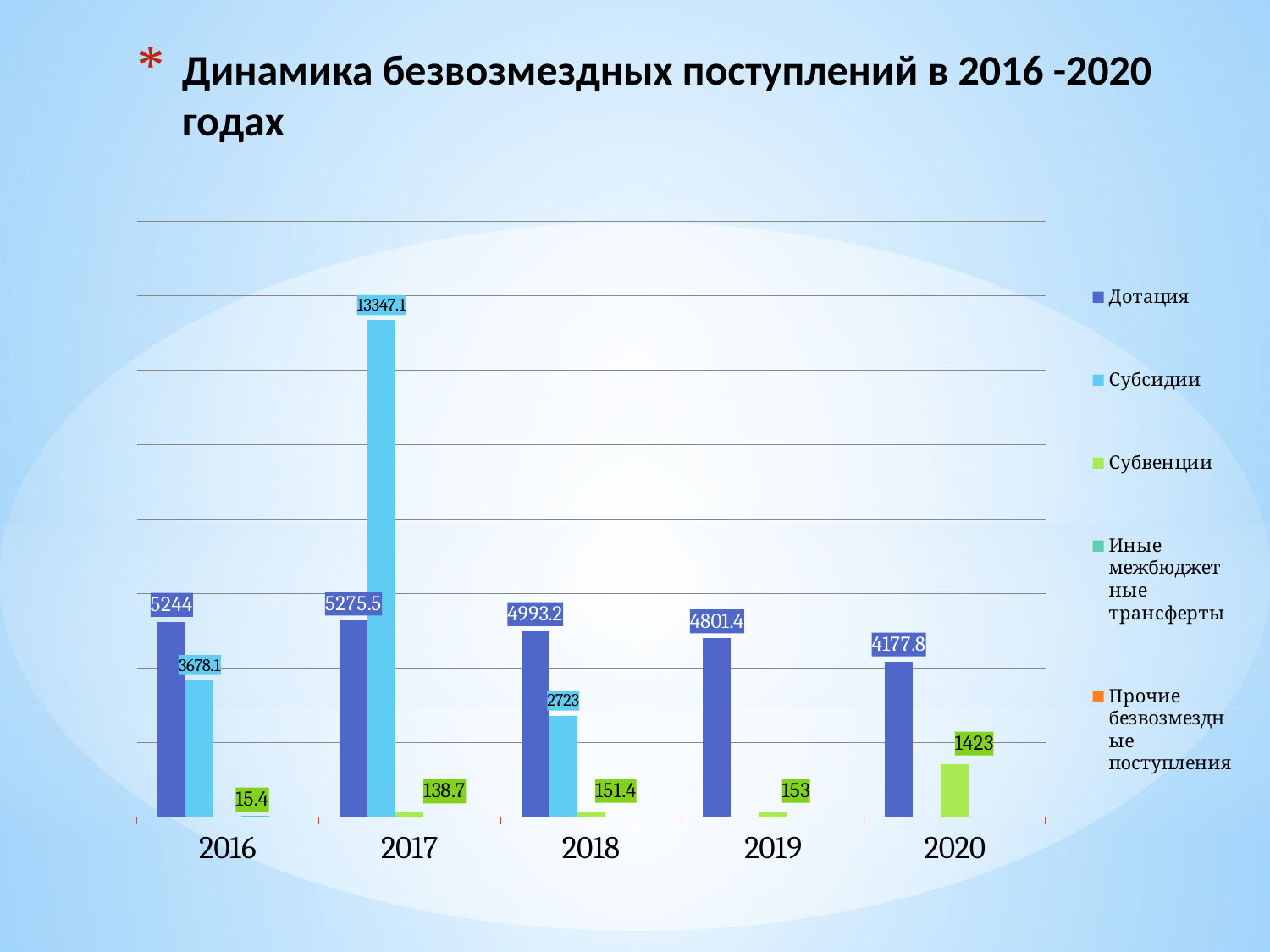
In which year is Дотация the lowest? 2020 What type of chart is shown on the slide? bar chart Which is larger in 2018: Дотация or Субсидии? Дотация What is the value of Субсидии in 2018? 2723 What is the difference between Дотация in 2016 and Дотация in 2020? 1066.2 How many series does the legend list? 5 How many years are shown on the x axis? 5 What is the value of Субсидии in 2017? 13347.1 In which year is Субсидии the highest? 2017 What is the value of Дотация in 2016? 5244 Does Дотация rise or fall from 2017 to 2020? fall What is the value of Субвенции in 2020? 1423